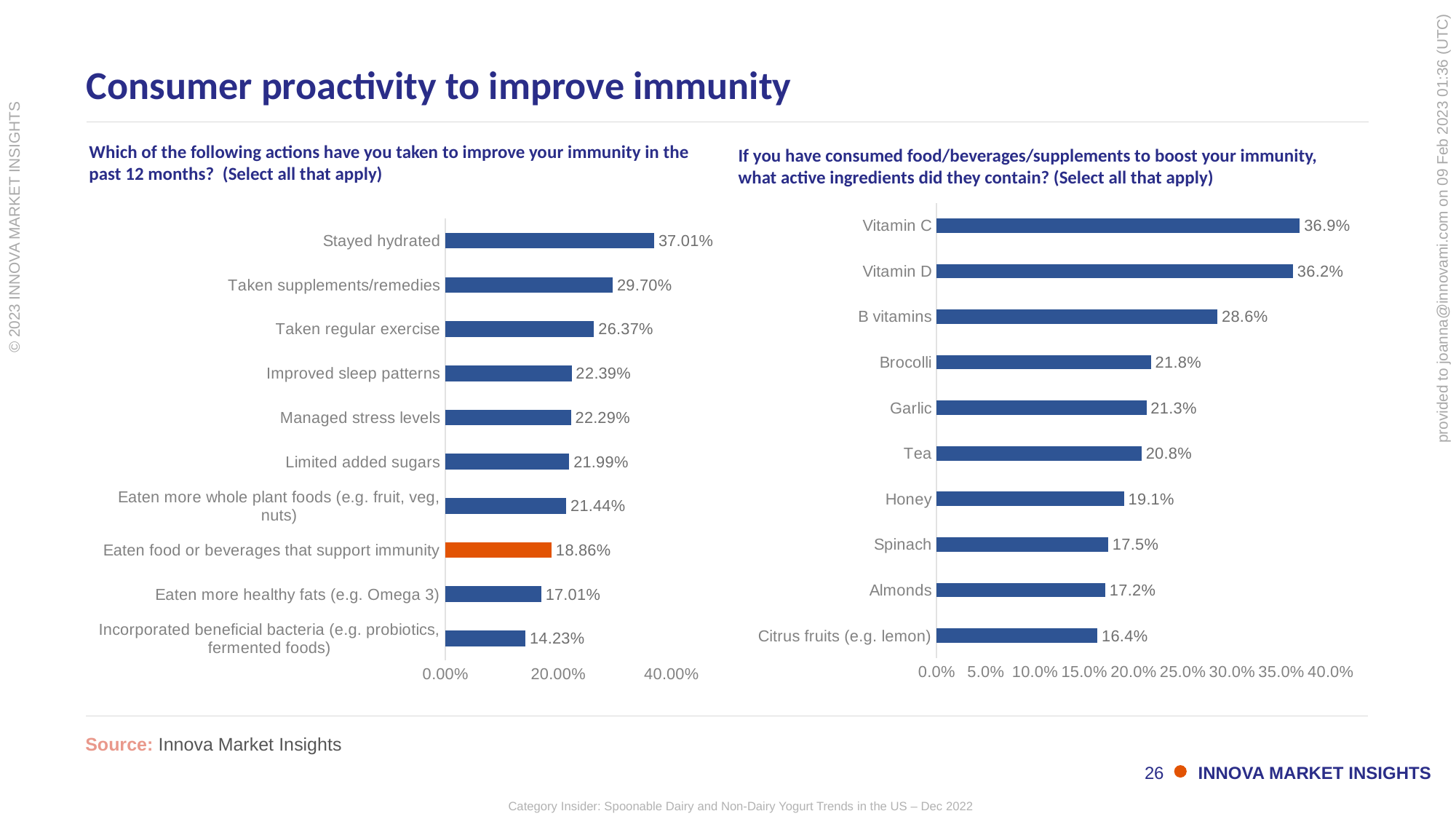
What type of chart is the right chart on active ingredients? Bar chart In the right chart on active ingredients, what is the value for Garlic? 21.3% In the left chart on actions taken to improve immunity, what is the value for 'Eaten food or beverages that support immunity'? 18.86% In the left chart on actions taken to improve immunity, what is the difference between 'Stayed hydrated' and 'Taken supplements/remedies'? 7.31% In the right chart on active ingredients, what percentage is shown for Vitamin C? 36.9% In the left chart on actions taken to improve immunity, how many actions are listed? 10 In the right chart on active ingredients, which ingredient has the highest percentage? Vitamin C In the left chart on actions taken to improve immunity, which bar is coloured orange instead of blue? Eaten food or beverages that support immunity In the left chart on actions taken to improve immunity, which action has the lowest percentage? Incorporated beneficial bacteria (e.g. probiotics, fermented foods) In the right chart on active ingredients, which is larger: Honey or Spinach? Honey In the right chart on active ingredients, what is the difference between B vitamins and Brocolli? 6.8% In the left chart on actions taken to improve immunity, what percentage of respondents stayed hydrated? 37.01%